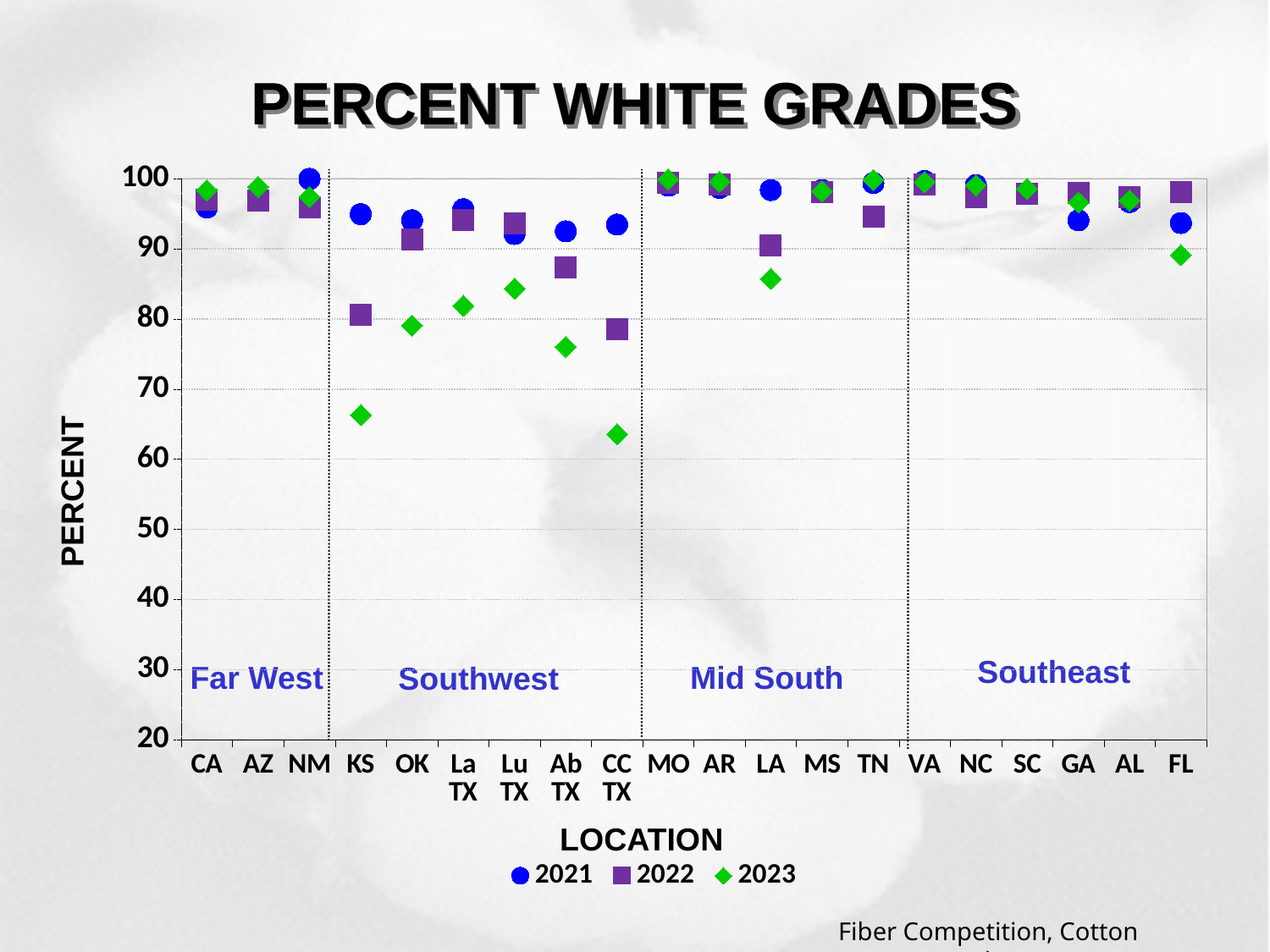
For KS, which series has the larger value, 2021 or 2023? 2021 How many locations are plotted along the x axis? 20 Is the 2023 value for LA greater or less than 80? greater Is the 2023 value for CC TX greater or less than 70? less Which location has the lowest 2023 value? CC TX Is the 2022 value for CC TX greater or less than 80? less What kind of chart is shown on the slide? scatter chart How many series does the legend list? 3 Which marker shape and colour represents the 2023 series in the legend? green diamond What is the title of the chart? PERCENT WHITE GRADES